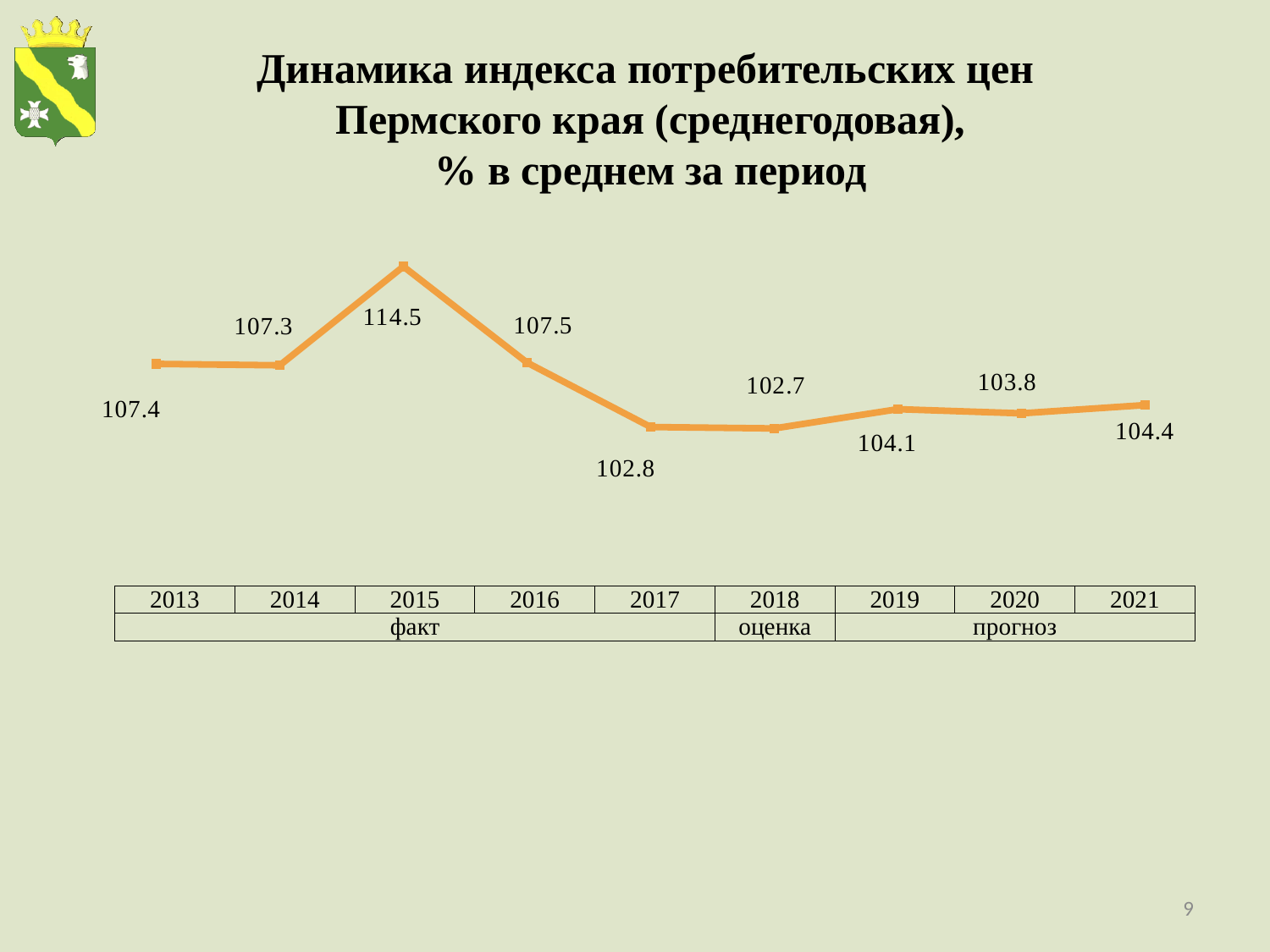
Which is larger, the value for 2016 or the value for 2019? 2016 Which year has the lowest value? 2018 What kind of chart is this? line chart What is the difference between the values for 2015 and 2016? 7.0 What is the value for 2021? 104.4 How many years are plotted on the chart? 9 Do the values rise or fall from 2016 to 2018? fall What is the value for 2018? 102.7 What is the value for 2013? 107.4 What is the value for 2015? 114.5 Which year has the highest value? 2015 What is the difference between the values for 2019 and 2020? 0.3